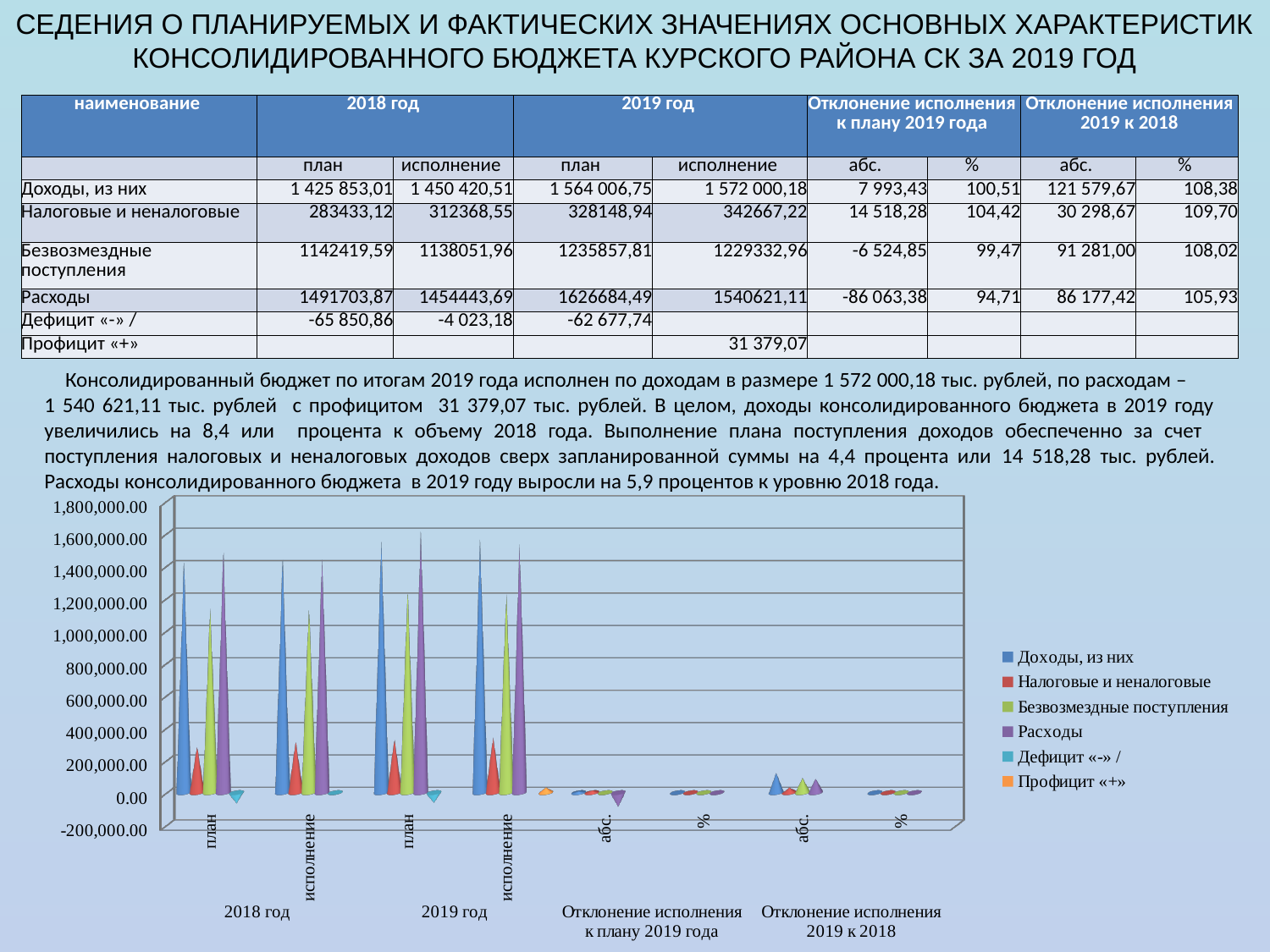
Is the value for Доходы, из них in the 2018 год план category greater or less than 1,200,000.00? greater How many series does the chart legend list? 6 What colour represents the Расходы series in the chart? purple Is the value for Безвозмездные поступления in the 2019 год план category greater or less than 1,000,000.00? greater How many categories are shown along the x axis of the chart? 8 What is the last entry listed in the chart legend? Профицит «+» In the 2019 год исполнение category, which is larger: Безвозмездные поступления or Налоговые и неналоговые? Безвозмездные поступления What kind of chart is shown on the slide? bar chart In the 2018 год план category, which is larger: Доходы, из них or Налоговые и неналоговые? Доходы, из них Which series has the lowest value in the 2018 год план category? Дефицит «-» / Is the value for Налоговые и неналоговые in the 2018 год план category greater or less than 400,000.00? less